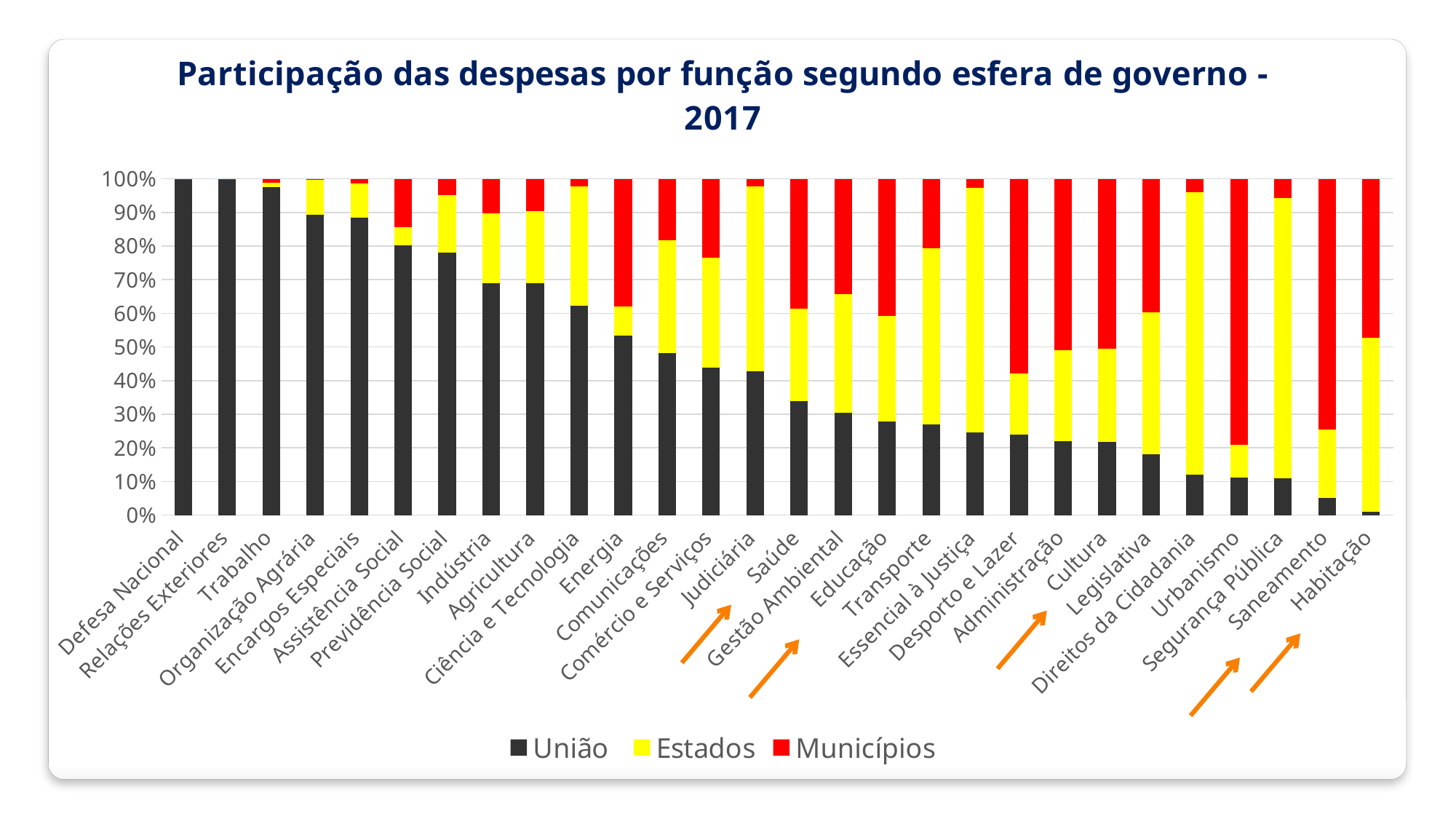
What is the title of the chart? Participação das despesas por função segundo esfera de governo - 2017 Does the União share generally rise or fall moving from left to right along the x axis? fall Which function has the lowest União share? Habitação How many series does the legend list? 3 Is the União share for Habitação greater or less than 10%? less Is the União share for Saúde greater or less than 30%? greater Which function has the largest Municípios share? Urbanismo What kind of chart is shown on the slide? Stacked bar chart How many functions (categories) are shown along the x axis? 28 Is the União share for Energia greater or less than 50%? greater Which has the larger Municípios share, Saúde or Cultura? Cultura Which series is shown in red in the legend? Municípios